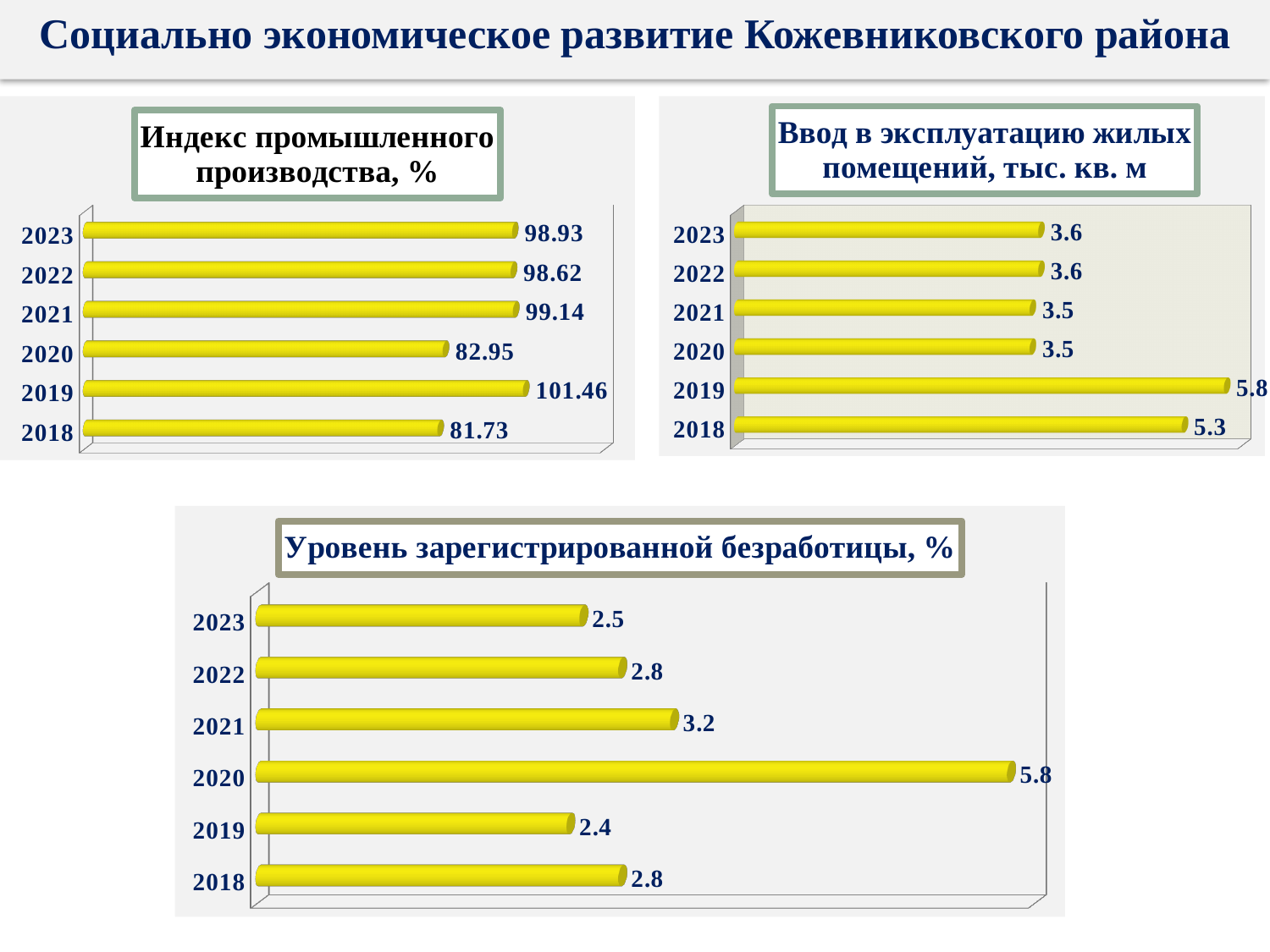
In the chart titled "Индекс промышленного производства, %", which year has the highest value? 2019 In the chart titled "Ввод в эксплуатацию жилых помещений, тыс. кв. м", what is the value for 2019? 5.8 In the chart titled "Ввод в эксплуатацию жилых помещений, тыс. кв. м", how many years are shown? 6 In the chart titled "Уровень зарегистрированной безработицы, %", which year has the lowest value? 2019 In the chart titled "Ввод в эксплуатацию жилых помещений, тыс. кв. м", which year has the highest value? 2019 In the chart titled "Индекс промышленного производства, %", what is the value for 2020? 82.95 What kind of chart is the chart titled "Уровень зарегистрированной безработицы, %"? bar chart In the chart titled "Уровень зарегистрированной безработицы, %", what is the value for 2021? 3.2 In the chart titled "Уровень зарегистрированной безработицы, %", which year has the highest value? 2020 In the chart titled "Индекс промышленного производства, %", which year has the lowest value? 2018 In the chart titled "Уровень зарегистрированной безработицы, %", is the value for 2022 larger or smaller than the value for 2023? larger In the chart titled "Индекс промышленного производства, %", what is the difference between the values for 2019 and 2018? 19.73